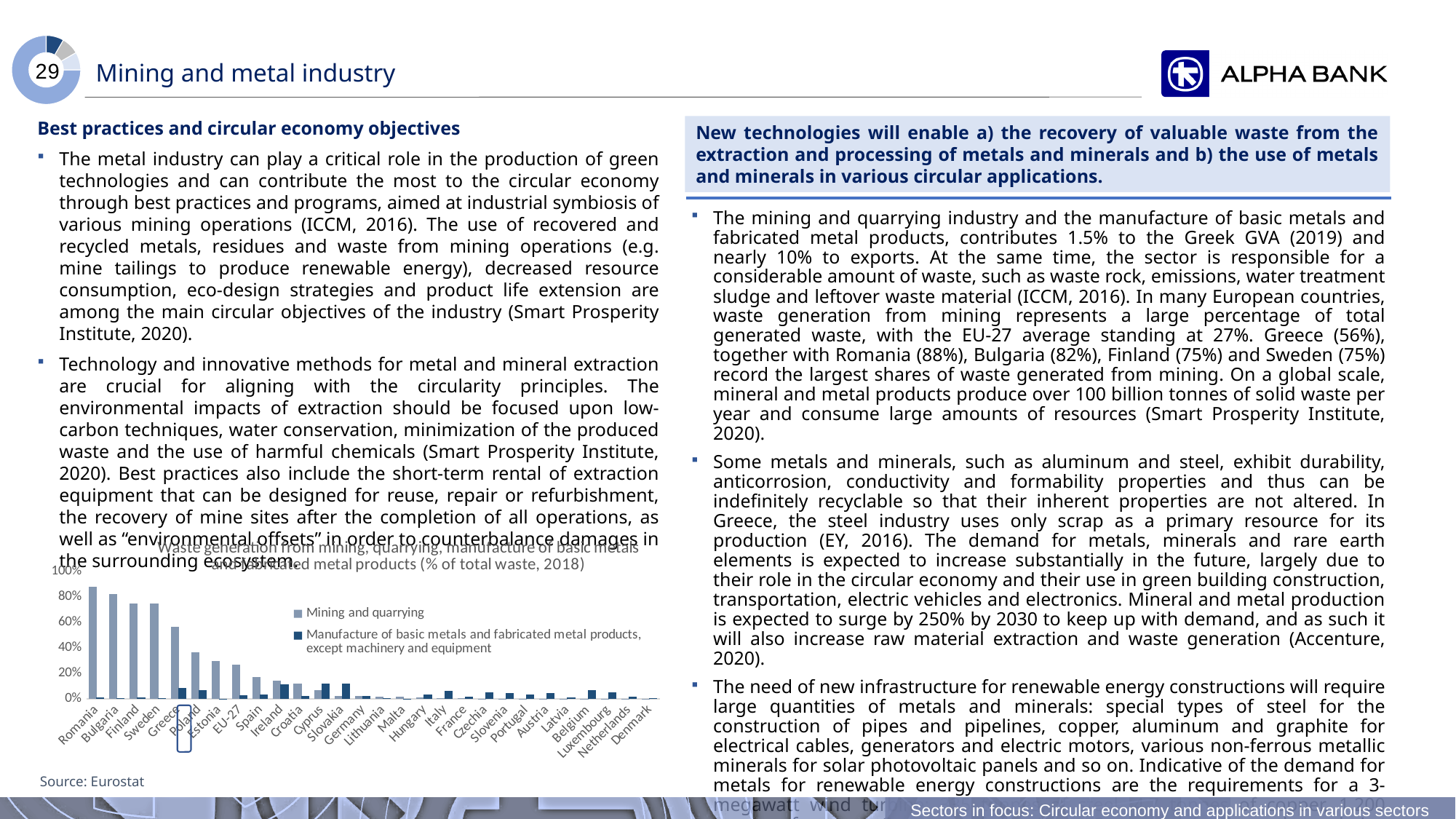
Which country has the highest Mining and quarrying share of total waste in the chart? Romania Which has a larger Mining and quarrying share, Sweden or Greece? Sweden What kind of chart is shown on the slide? bar chart Is the Mining and quarrying value for Finland greater or less than 60%? greater Is the Mining and quarrying value for EU-27 greater or less than 20%? greater Is the Mining and quarrying value for Poland greater or less than 40%? less Do the Mining and quarrying values rise or fall moving from left to right along the x axis? fall How many series does the chart legend list? 2 What is the source cited for the chart? Eurostat How many countries/regions are shown on the x axis of the chart? 28